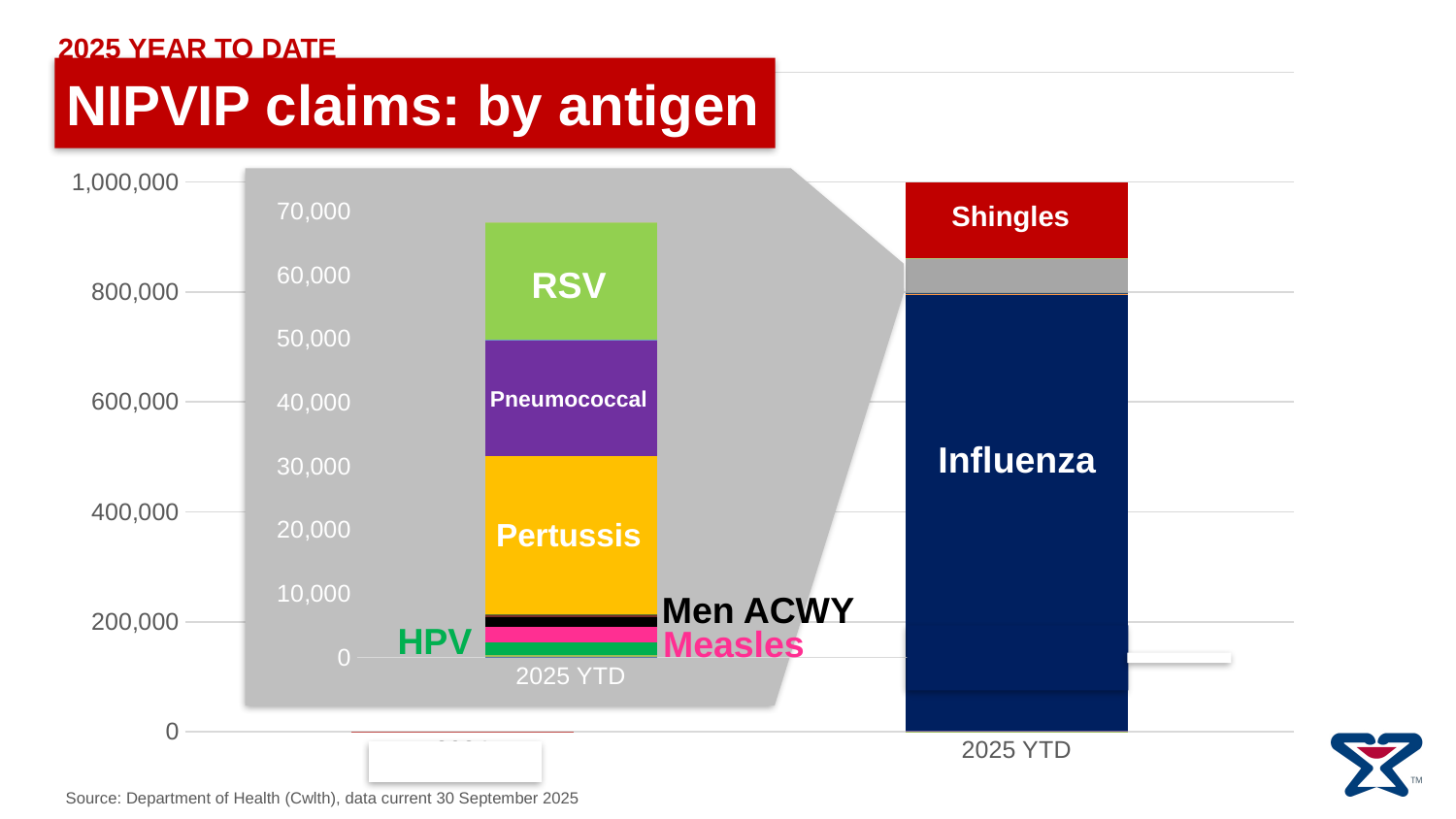
In the large chart on the right, which antigen segment is the largest? Influenza What is the title of the slide's chart? NIPVIP claims: by antigen What is the x-axis category label under the bar in the large chart on the right? 2025 YTD In the large chart on the right, which is larger: the Influenza segment or the Shingles segment? Influenza In the inset (grey background) chart, which antigen segment is the largest? Pertussis In the inset (grey background) chart, is the value for Pertussis greater or less than 20,000? greater In the inset (grey background) chart, which is larger: the RSV segment or the Measles segment? RSV In the large chart on the right, is the value for Influenza greater or less than 600,000? greater In the inset (grey background) chart, is the top of the stacked bar greater or less than 60,000? greater What kind of chart is the large chart on the right of the slide? Stacked bar chart How many labelled antigen segments are shown in the inset (grey background) chart? 6